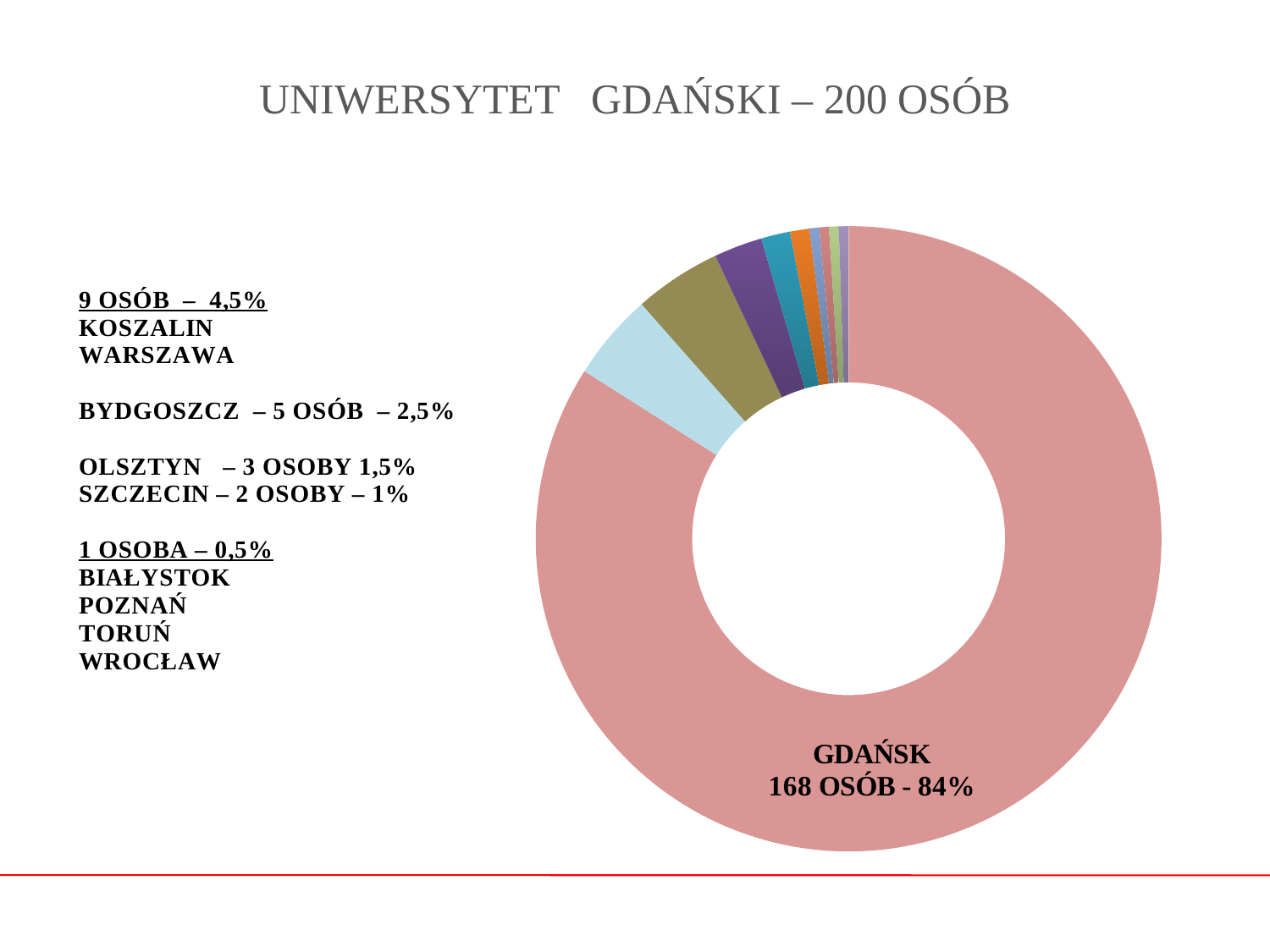
What share of the chart does Gdańsk account for? 84% Which is larger, the share for Bydgoszcz or the share for Szczecin? Bydgoszcz What is the difference in number of people between Gdańsk and Koszalin? 159 How many people are from Olsztyn? 3 OSOBY How many slices does the doughnut chart have? 10 What percentage share do Koszalin and Warszawa each have? 4,5% How many people does the Gdańsk slice represent? 168 OSÓB Which city has the largest slice in the chart? GDAŃSK What is the total number of people represented by the chart? 200 OSÓB How many people are from Bydgoszcz according to the slide? 5 OSÓB What is the title of the slide? UNIWERSYTET GDAŃSKI – 200 OSÓB What kind of chart is shown on the slide? Doughnut (pie) chart